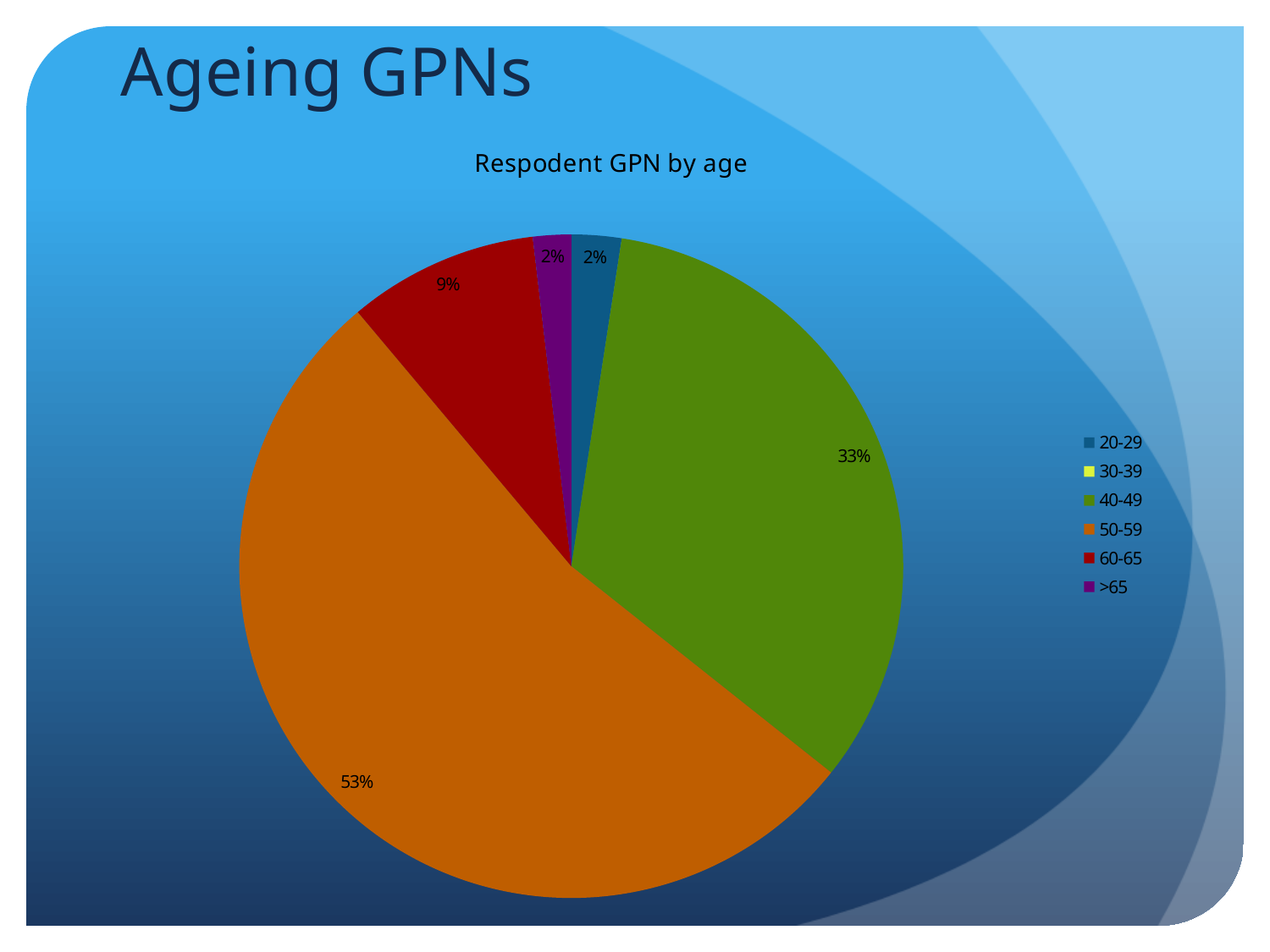
What percentage of respondent GPNs are aged 60-65? 9% What kind of chart is shown on the slide? pie chart What is the combined share of the 50-59 and 40-49 age groups? 86% What is the title of the chart? Respodent GPN by age What percentage of respondent GPNs are aged over 65 (>65)? 2% Which age group has the larger share: 40-49 or 60-65? 40-49 What percentage of respondent GPNs are aged 50-59? 53% Which age group has the largest share of the pie? 50-59 How many age groups are listed in the legend? 6 What percentage of respondent GPNs are aged 40-49? 33% What percentage of respondent GPNs are aged 20-29? 2% How many percentage points larger is the 50-59 share than the 40-49 share? 20 percentage points